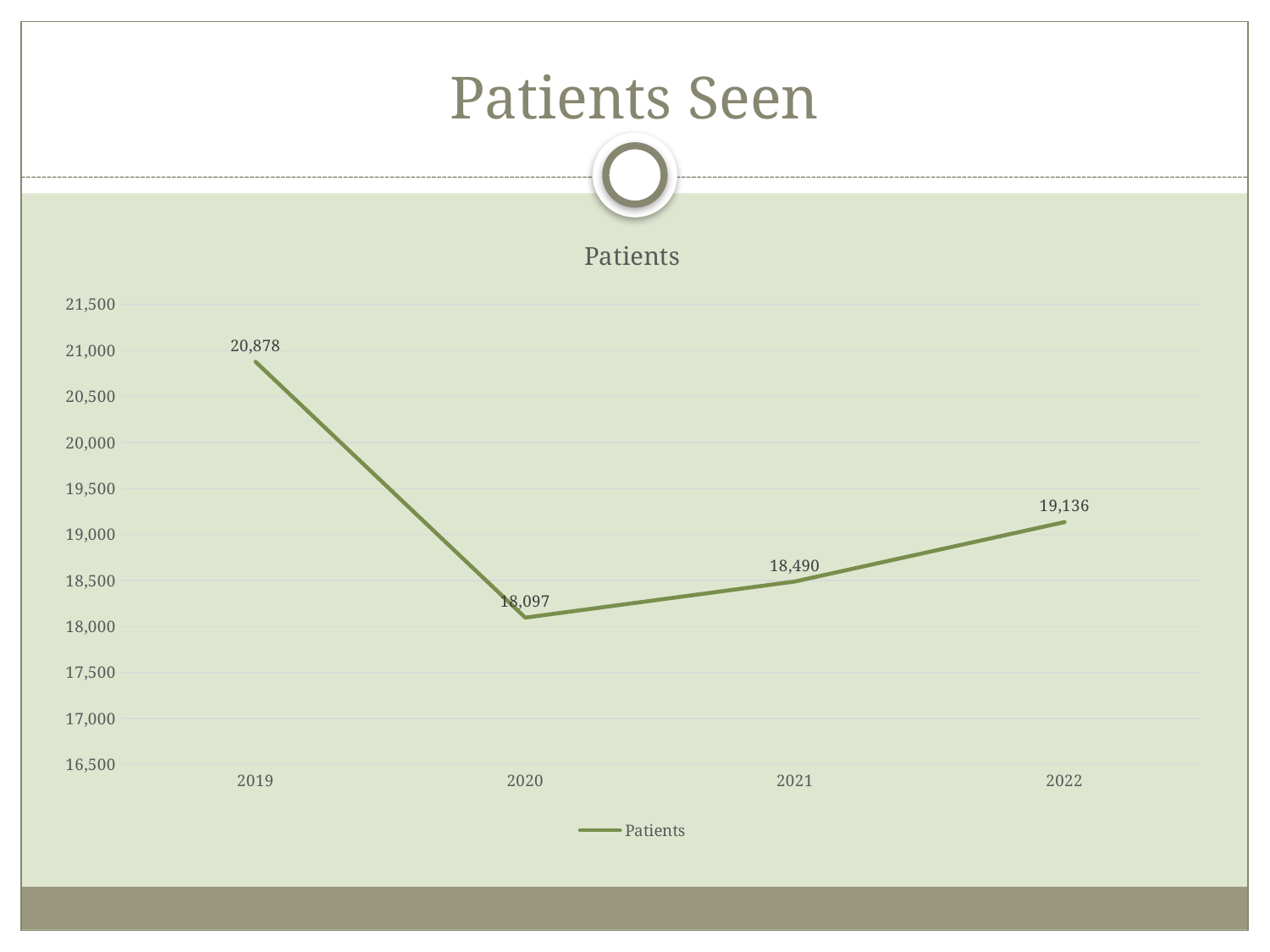
Do the values rise or fall from 2020 to 2022? rise How many years are plotted on the chart? 4 Which year had more patients seen, 2021 or 2022? 2022 Is the value for 2021 greater or less than 19,000? less What kind of chart is shown on the slide? line chart What is the difference in patients seen between 2022 and 2021? 646 What is the difference in patients seen between 2019 and 2020? 2,781 What is the number of patients seen in 2022? 19,136 Which year has the highest number of patients seen? 2019 Which year has the lowest number of patients seen? 2020 What is the number of patients seen in 2020? 18,097 What is the number of patients seen in 2019? 20,878